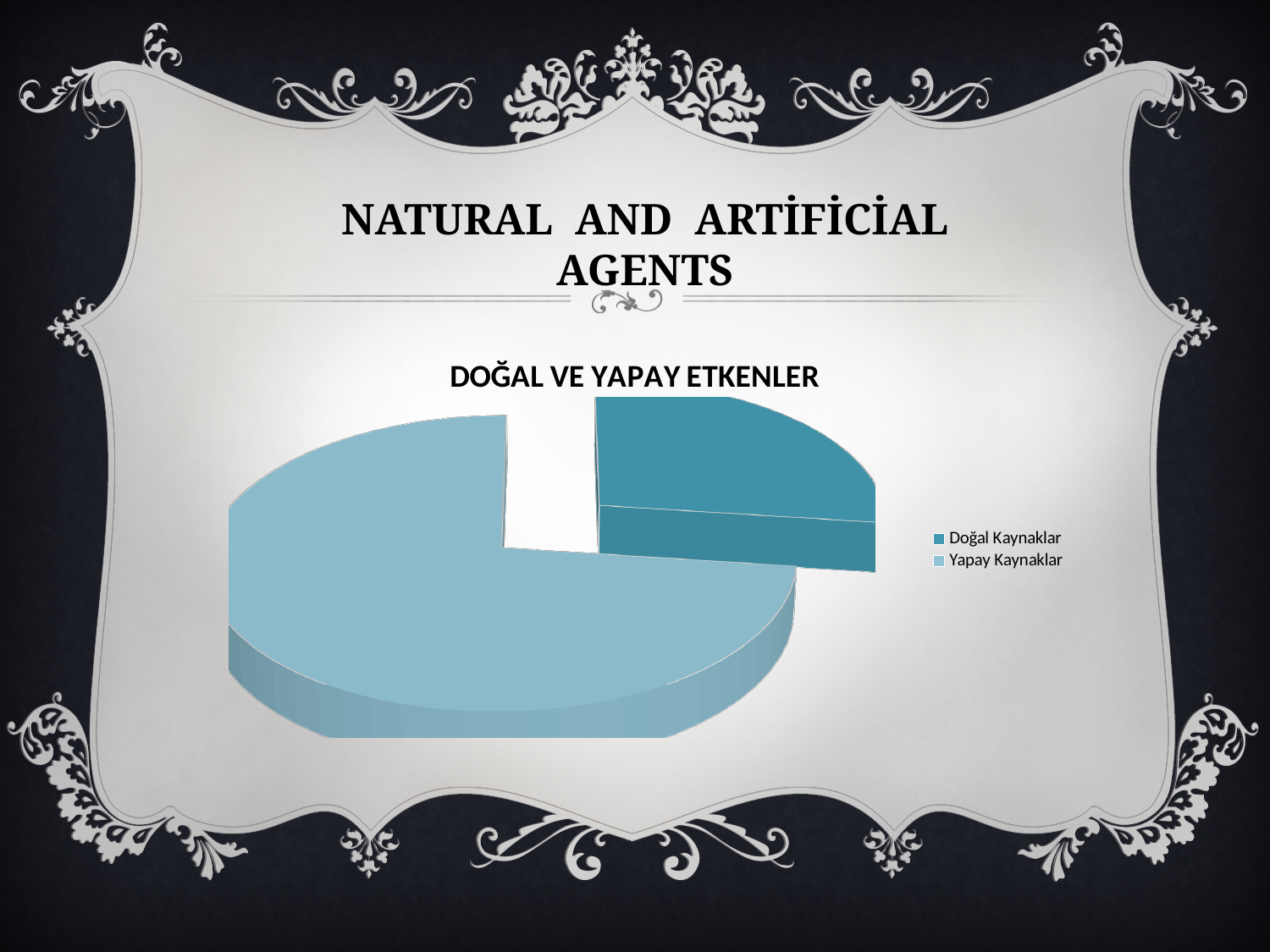
Which category has the largest slice of the pie? Yapay Kaynaklar How many entries does the chart legend list? 2 Which slice is larger, Doğal Kaynaklar or Yapay Kaynaklar? Yapay Kaynaklar Which legend entry is shown in the darker teal colour? Doğal Kaynaklar What is the title of the chart? DOĞAL VE YAPAY ETKENLER How many slices does the pie chart have? 2 Which category has the smallest slice of the pie? Doğal Kaynaklar What kind of chart is shown on the slide? pie chart